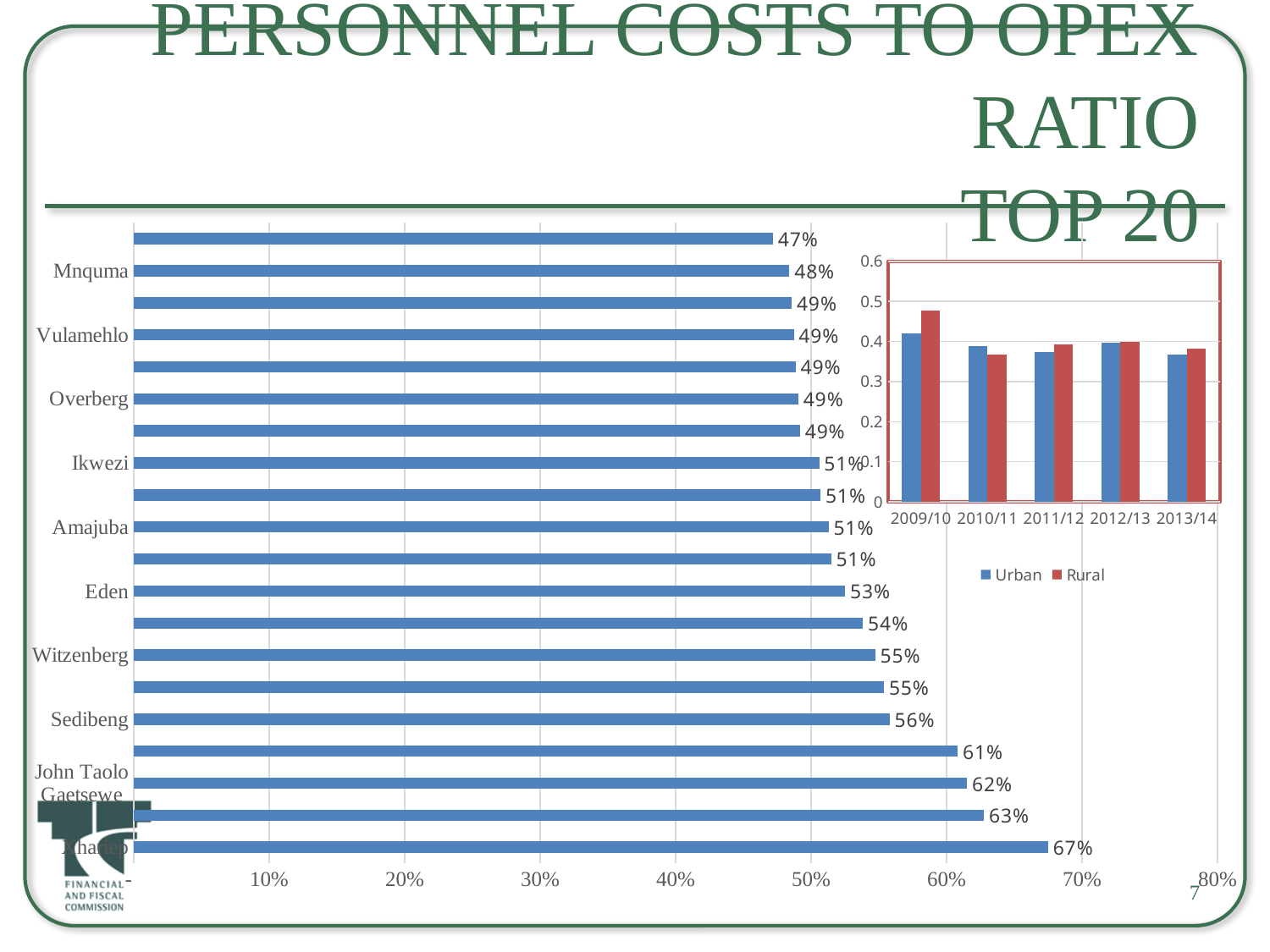
In the large horizontal bar chart, how many bars are plotted? 20 In the large horizontal bar chart, what is the value for Eden? 53% In the small Urban/Rural chart on the right, is the Rural value for 2009/10 greater or less than 0.4? greater In the small Urban/Rural chart on the right, how many years are shown on the x axis? 5 In the large horizontal bar chart, what is the value for John Taolo Gaetsewe? 62% In the large horizontal bar chart, which has the larger value, Witzenberg or Ikwezi? Witzenberg In the large horizontal bar chart, what is the value for Sedibeng? 56% In the large horizontal bar chart, what is the highest value shown on any bar? 67% In the small Urban/Rural chart on the right, which series has the higher value in 2009/10? Rural In the large horizontal bar chart, what is the value for Mnquma? 48% In the large horizontal bar chart, what is the difference between the values for Sedibeng and Mnquma? 8% In the small Urban/Rural chart on the right, how many series does the legend list? 2